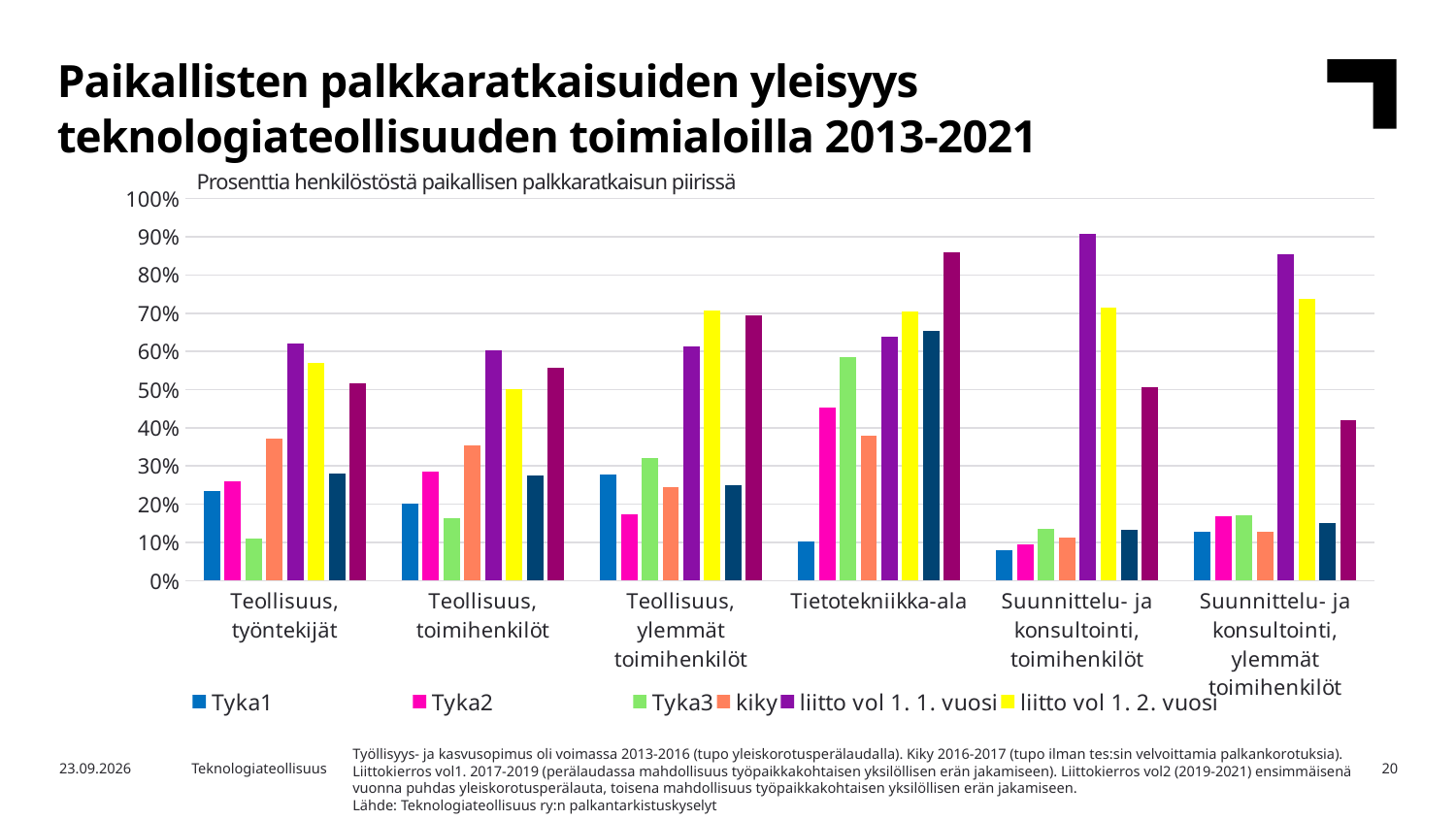
Is the value for liitto vol 1. 1. vuosi in Tietotekniikka-ala greater or less than 60%? greater Which category has the highest value for liitto vol 1. 1. vuosi? Suunnittelu- ja konsultointi, toimihenkilöt Which category has the lowest value for Tyka1? Suunnittelu- ja konsultointi, toimihenkilöt How many series does the chart legend list? 6 Is the value for Tyka1 in Teollisuus, työntekijät greater or less than 20%? greater What kind of chart is shown on the slide? bar chart How many categories are shown on the x axis of the chart? 6 Is the value for kiky in Teollisuus, työntekijät greater or less than 30%? greater Which is larger: the Tyka3 value for Tietotekniikka-ala or the Tyka3 value for Teollisuus, työntekijät? Tietotekniikka-ala What is the subtitle printed above the chart? Prosenttia henkilöstöstä paikallisen palkkaratkaisun piirissä